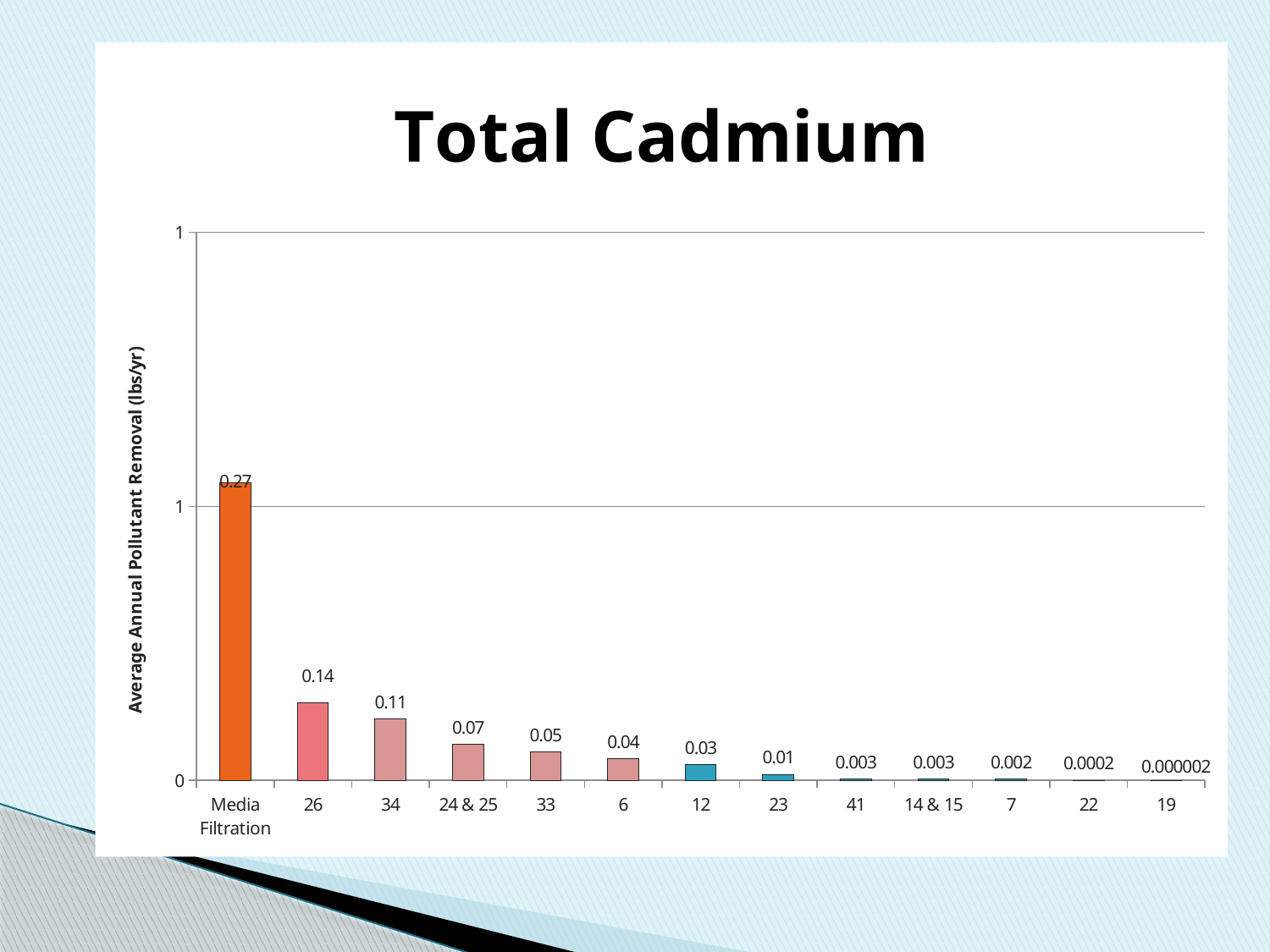
Which category has the highest average annual pollutant removal? Media Filtration What is the value shown for category 26? 0.14 What is the value shown for category 19? 0.000002 What kind of chart is shown on the slide? Bar chart Which has a larger value, category 6 or category 12? 6 What is the value shown for category 24 & 25? 0.07 What is the average annual pollutant removal for Media Filtration? 0.27 What is the difference between the values for Media Filtration and category 26? 0.13 Which category has the lowest average annual pollutant removal? 19 What is the title of the chart? Total Cadmium What is the difference between the values for category 34 and category 33? 0.06 How many categories are shown on the x axis? 13